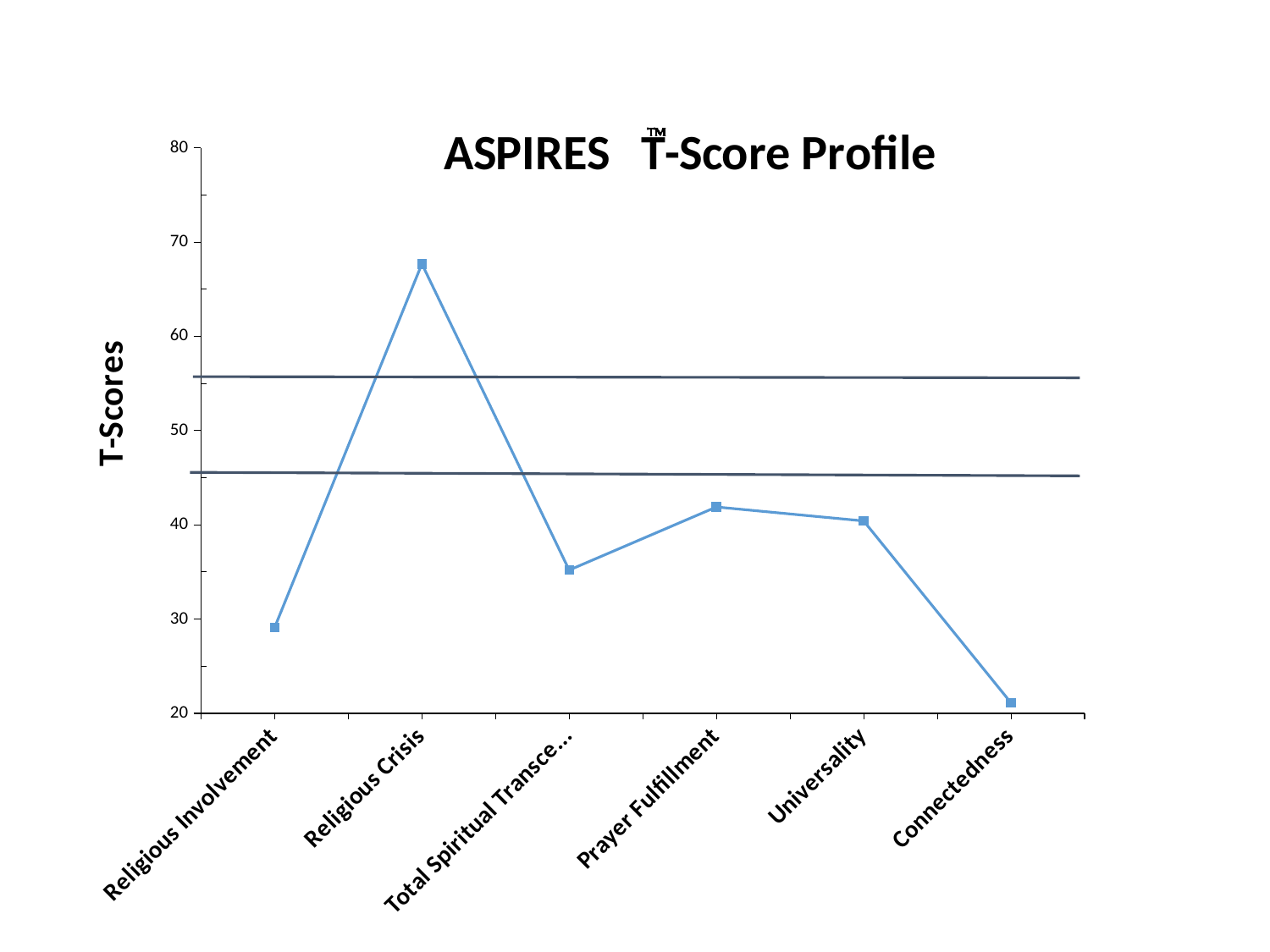
Is the value for Religious Involvement greater or less than 40? less Which category has the highest T-score? Religious Crisis Which is larger, the value for Religious Involvement or the value for Universality? Universality How many categories are plotted along the x axis? 6 Is the value for Connectedness greater or less than 30? less Which category has the lowest T-score? Connectedness Is the value for Religious Crisis greater or less than 60? greater What is the label on the vertical axis? T-Scores Does the line rise or fall from Universality to Connectedness? fall What kind of chart is shown on the slide? line chart